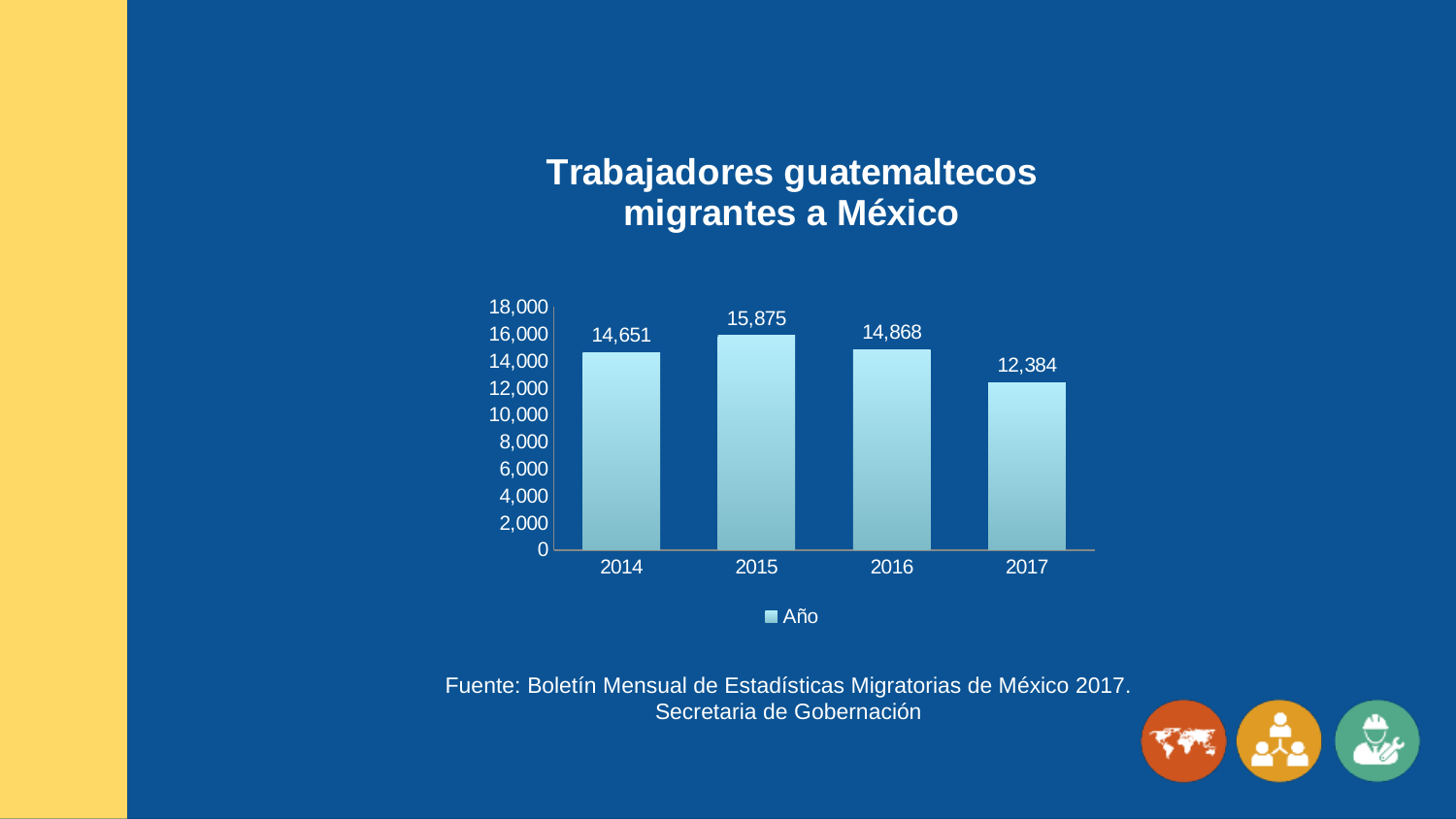
How many series does the legend list? 1 What kind of chart is shown? bar chart Is the value for 2017 greater or less than 14,000? less What is the value for 2014? 14,651 What is the difference between the values for 2015 and 2017? 3,491 Do the values rise or fall from 2015 to 2017? fall Which is larger, the value for 2014 or the value for 2016? 2016 How many years are shown on the x axis? 4 What is the title of the chart? Trabajadores guatemaltecos migrantes a México Which year has the lowest value? 2017 Which year has the highest value? 2015 What is the value for 2017? 12,384